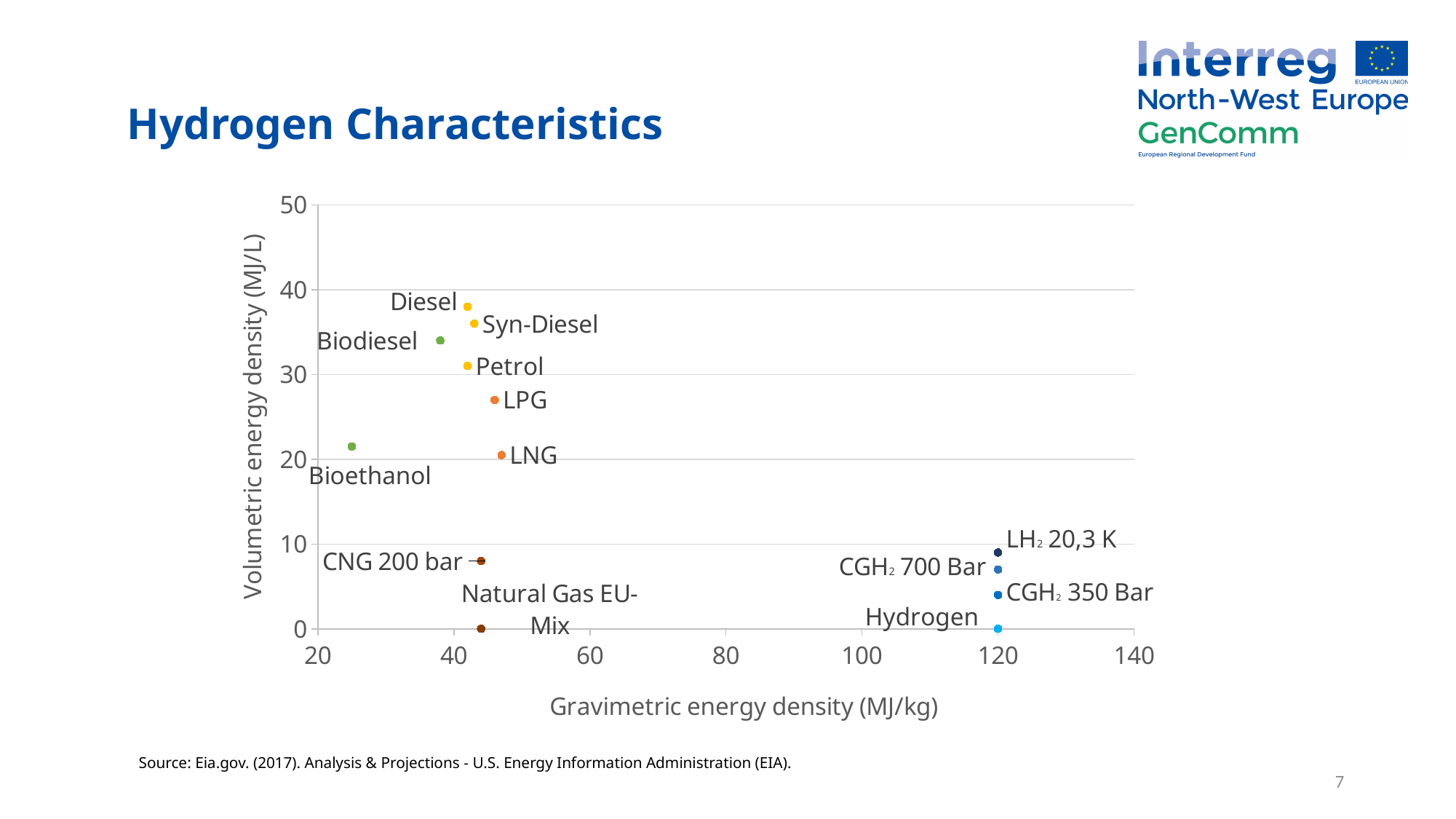
Is the volumetric energy density of CNG 200 bar greater or less than 10 MJ/L? less Is the gravimetric energy density of Hydrogen greater or less than 100 MJ/kg? greater Which has a higher volumetric energy density, LH2 20,3 K or CGH2 350 Bar? LH2 20,3 K What is the label of the y axis? Volumetric energy density (MJ/L) Which fuel has the highest volumetric energy density on the chart? Diesel Which has a higher volumetric energy density, LPG or LNG? LPG Is the volumetric energy density of Diesel greater or less than 30 MJ/L? greater What kind of chart is shown on the slide? scatter chart What is the label of the x axis? Gravimetric energy density (MJ/kg) Which fuel has the lowest gravimetric energy density on the chart? Bioethanol How many labelled data points are plotted on the chart? 13